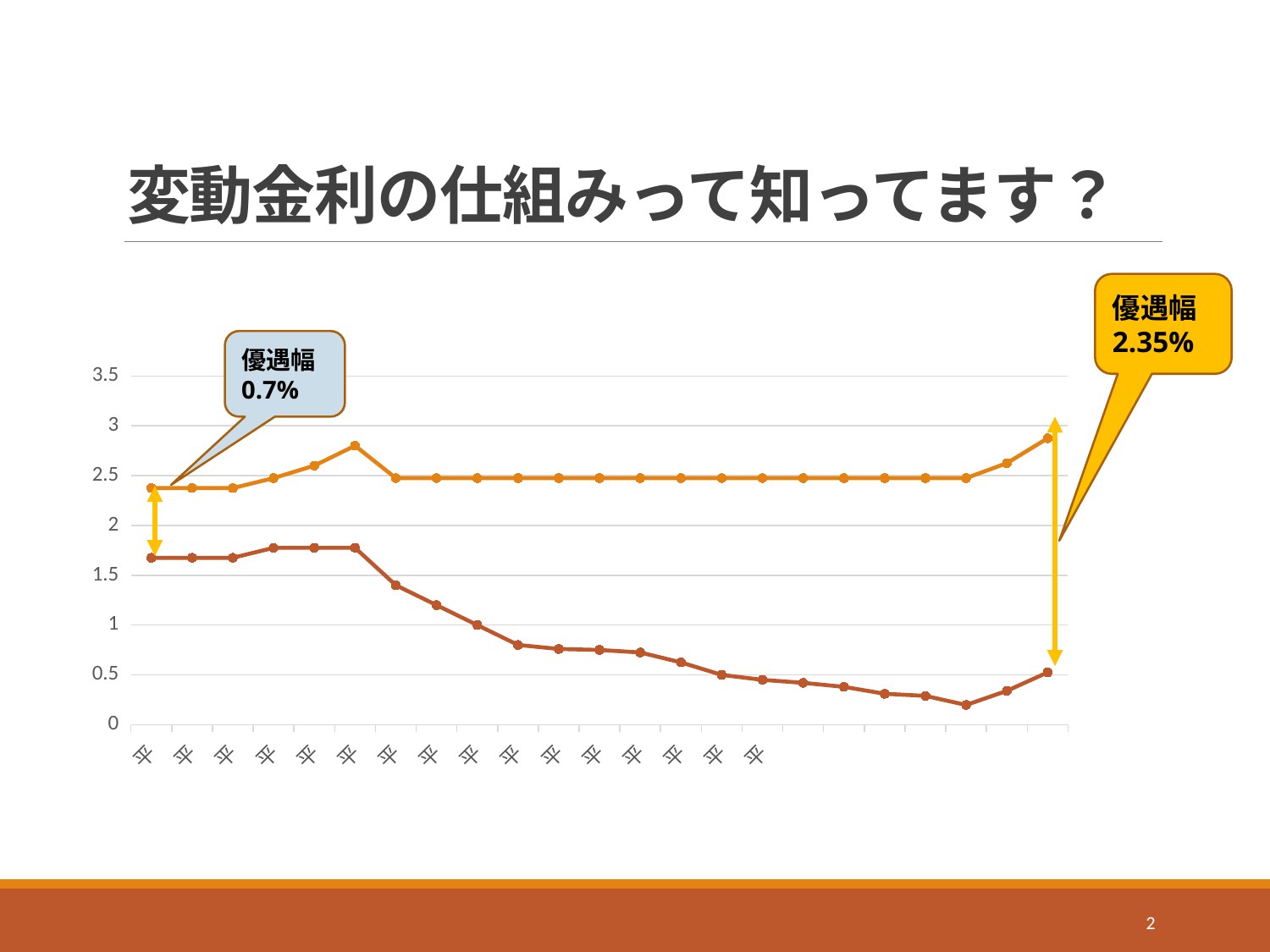
What 優遇幅 (preferential margin) value is shown in the callout at the right of the chart? 2.35% How many lines (series) are plotted on the chart? 2 Is the value of the lower (brown) line at its first point greater or less than 1.5? greater Does the lower (brown) line overall rise or fall from left to right? fall What 優遇幅 (preferential margin) value is shown in the callout at the left of the chart? 0.7% Is the value of the upper (orange) line at its last point greater or less than 3? less What kind of chart is shown on the slide? line chart At the last data point, which line has the larger value, the upper orange line or the lower brown line? the upper orange line Is the value of the upper (orange) line at its first point greater or less than 2? greater How many data points does each line on the chart have? 23